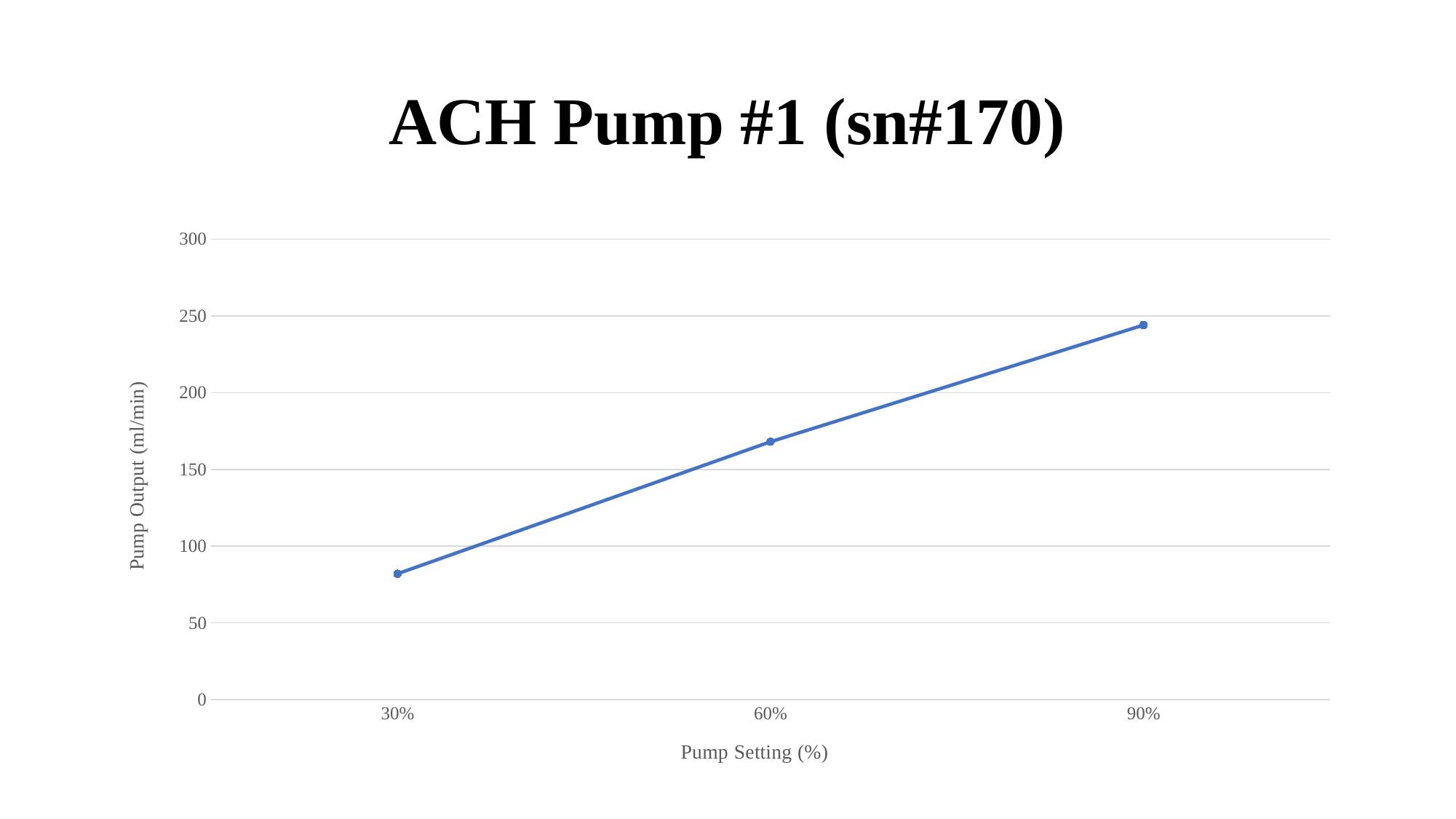
What is the title of the chart? ACH Pump #1 (sn#170) What is the label of the y axis? Pump Output (ml/min) Is the pump output at the 30% setting greater or less than 100? less Is the pump output at the 60% setting greater or less than 150? greater What kind of chart is shown on the slide? line chart Which pump setting has the highest pump output? 90% Is the pump output at the 60% setting greater or less than 200? less Which has the larger pump output, the 60% setting or the 90% setting? 90% How many data points are plotted on the line? 3 Does the pump output rise or fall as the pump setting increases from 30% to 90%? rise Which pump setting has the lowest pump output? 30%